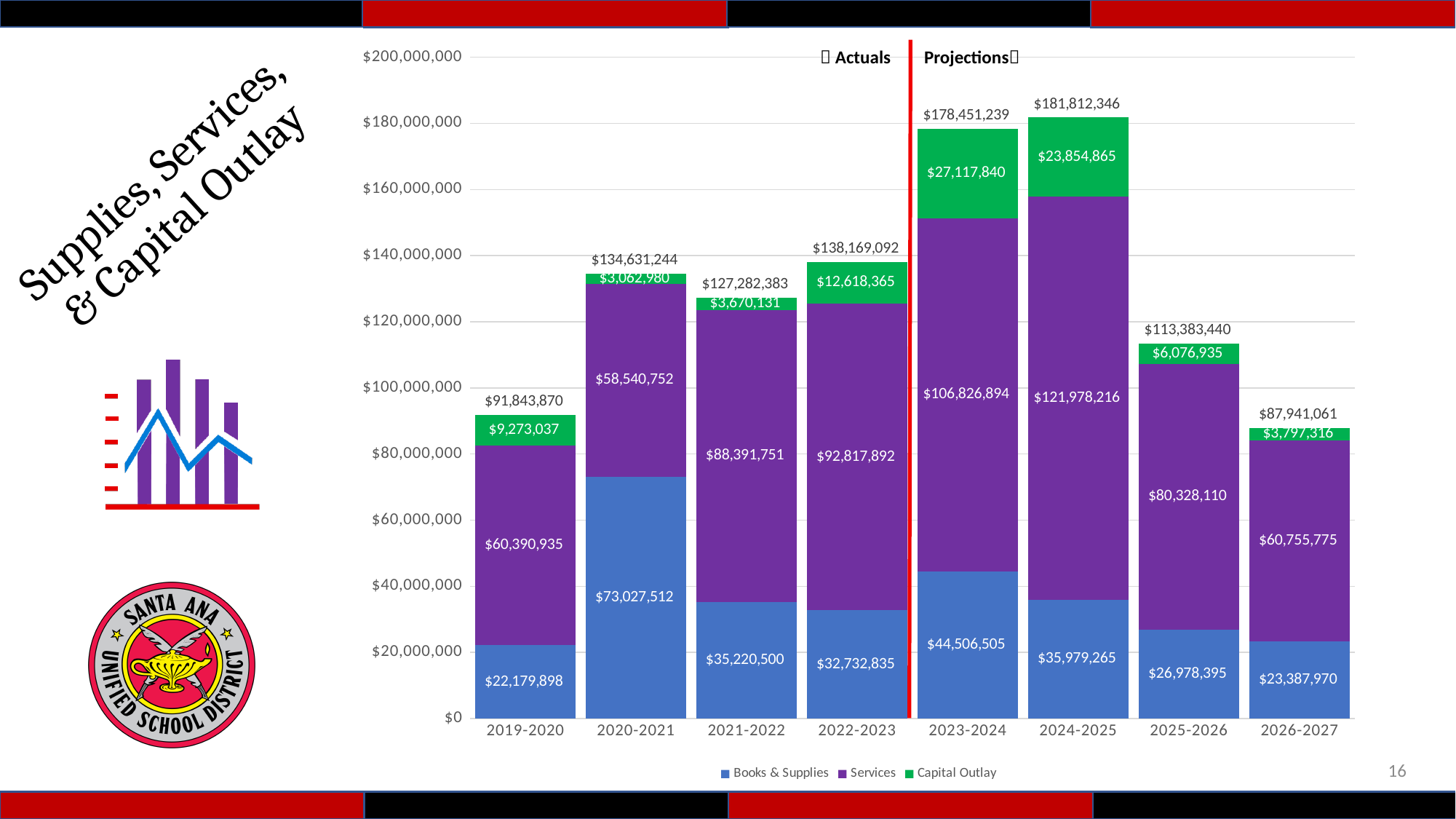
Which is larger, the Books & Supplies value for 2021-2022 or for 2022-2023? 2021-2022 How many series does the legend list? 3 Is the total for 2025-2026 greater or less than $120,000,000? less What is the Books & Supplies value for 2020-2021? $73,027,512 What is the total of the stacked bar for 2025-2026? $113,383,440 What kind of chart is shown on the slide? stacked bar chart What is the difference between the Services values for 2024-2025 and 2023-2024? $15,151,322 What is the Services value for 2022-2023? $92,817,892 Which year has the lowest total stacked bar? 2026-2027 Which year has the highest total stacked bar? 2024-2025 What is the Capital Outlay value for 2023-2024? $27,117,840 How many years are shown on the x axis? 8